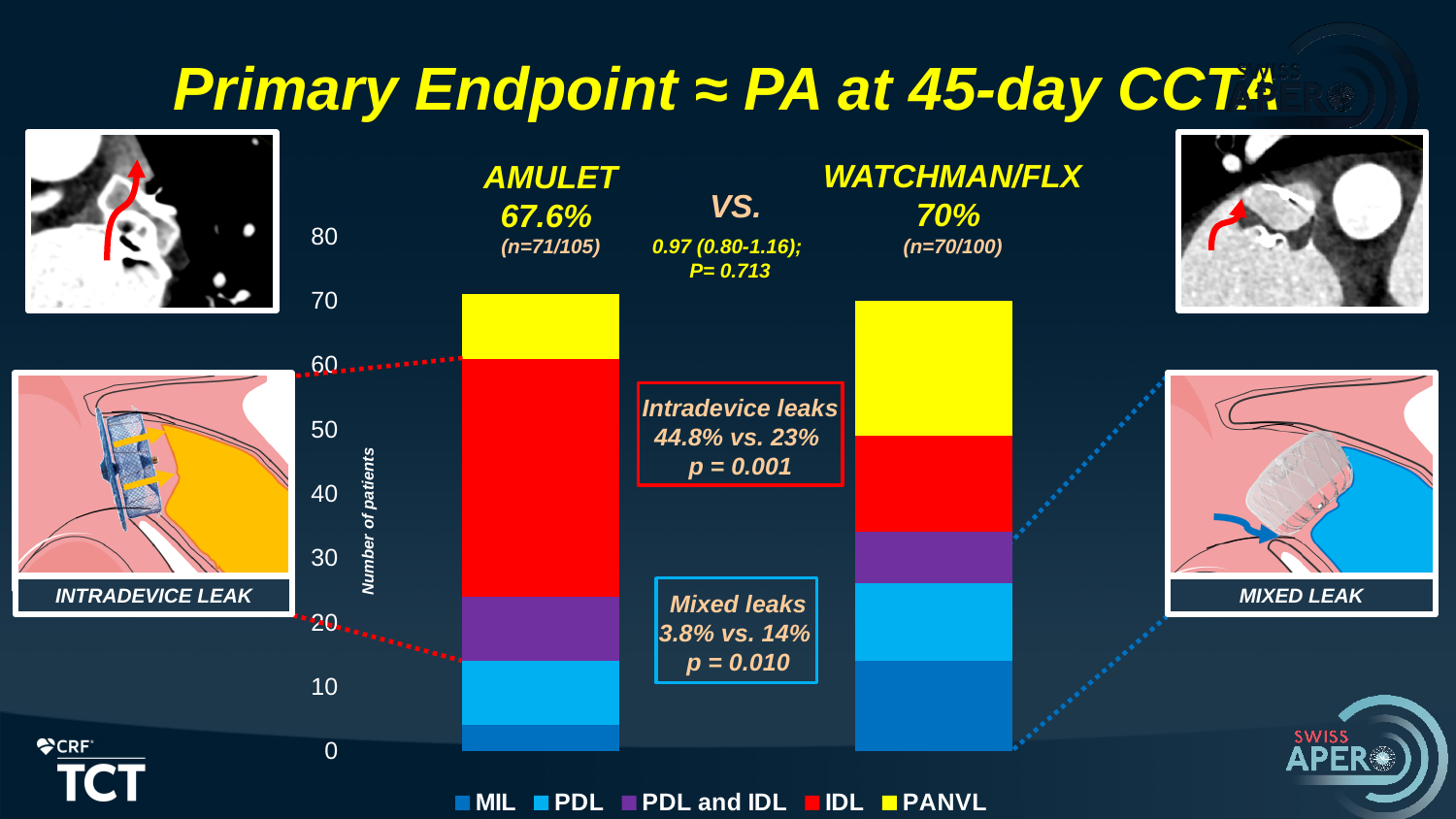
What percentage is printed above the WATCHMAN/FLX bar? 70% Which legend entry is shown in yellow? PANVL Is the MIL (dark blue) segment of the AMULET bar greater or less than 10 patients? less Is the IDL (red) segment of the AMULET bar greater or less than 30 patients? greater What is the difference in percentage points between the WATCHMAN/FLX (70%) and AMULET (67.6%) printed percentages? 2.4 percentage points Which bar has the larger IDL (red) segment, AMULET or WATCHMAN/FLX? AMULET How many bars (device groups) are plotted in the chart? 2 What percentage is printed above the AMULET bar? 67.6% How many series does the chart legend list? 5 Which device group has the higher printed primary endpoint percentage, AMULET or WATCHMAN/FLX? WATCHMAN/FLX What kind of chart is shown on the slide? Stacked bar chart What is the title of the vertical axis? Number of patients